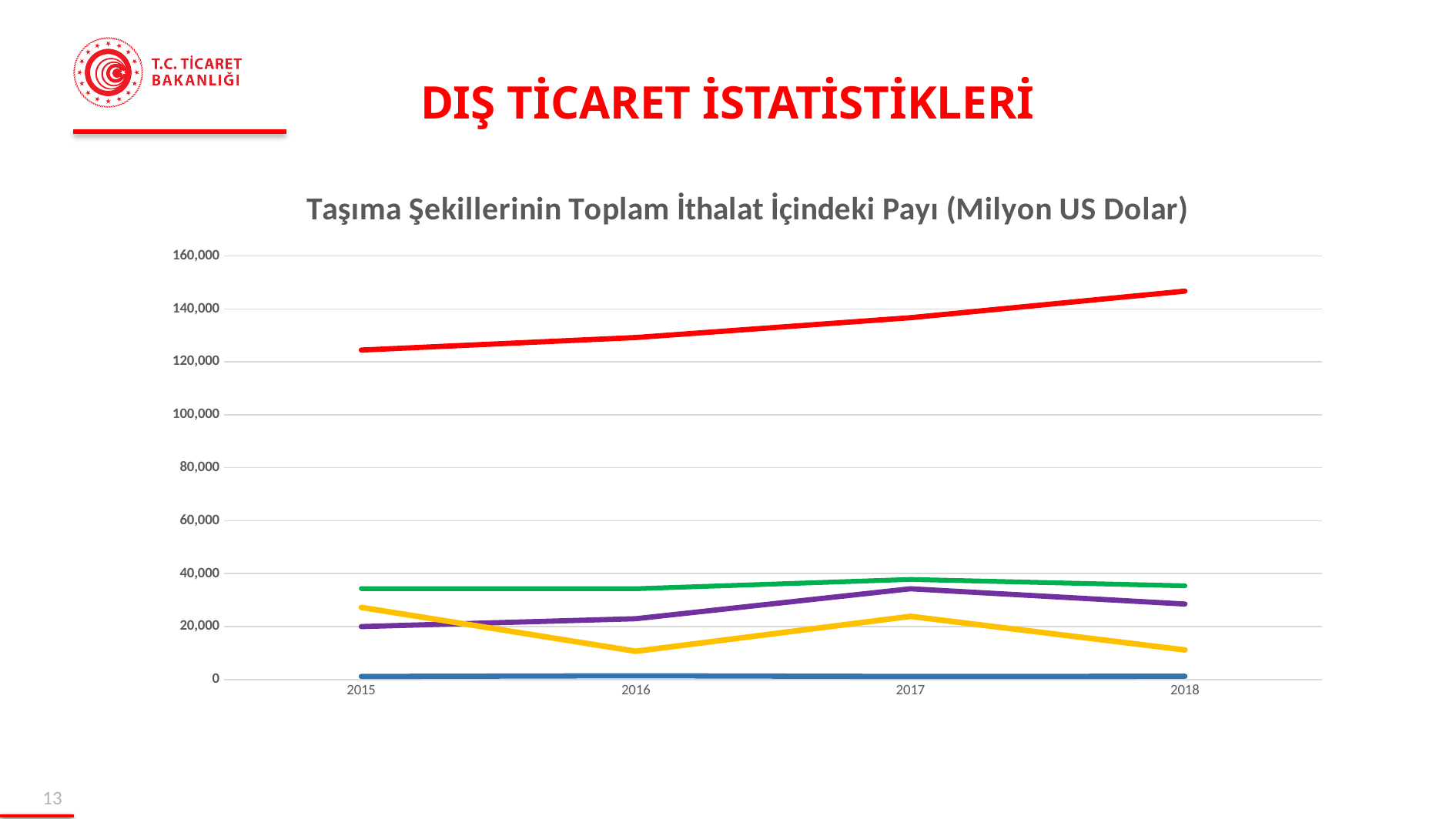
In 2016, which is larger: the value of the purple line or the value of the yellow line? the purple line How many years are shown on the x axis of the chart? 4 What kind of chart is shown on the slide? line chart Which line has the highest values across all years? the red line Is the value of the yellow line in 2016 greater or less than 20,000? less Is the value of the red line in 2018 greater or less than 140,000? greater How many lines are plotted on the chart? 5 What is the title of the chart? Taşıma Şekillerinin Toplam İthalat İçindeki Payı (Milyon US Dolar) Does the red line rise or fall from 2015 to 2018? rise Is the value of the green line in 2015 greater or less than 40,000? less Which line has the lowest values across all years? the blue line